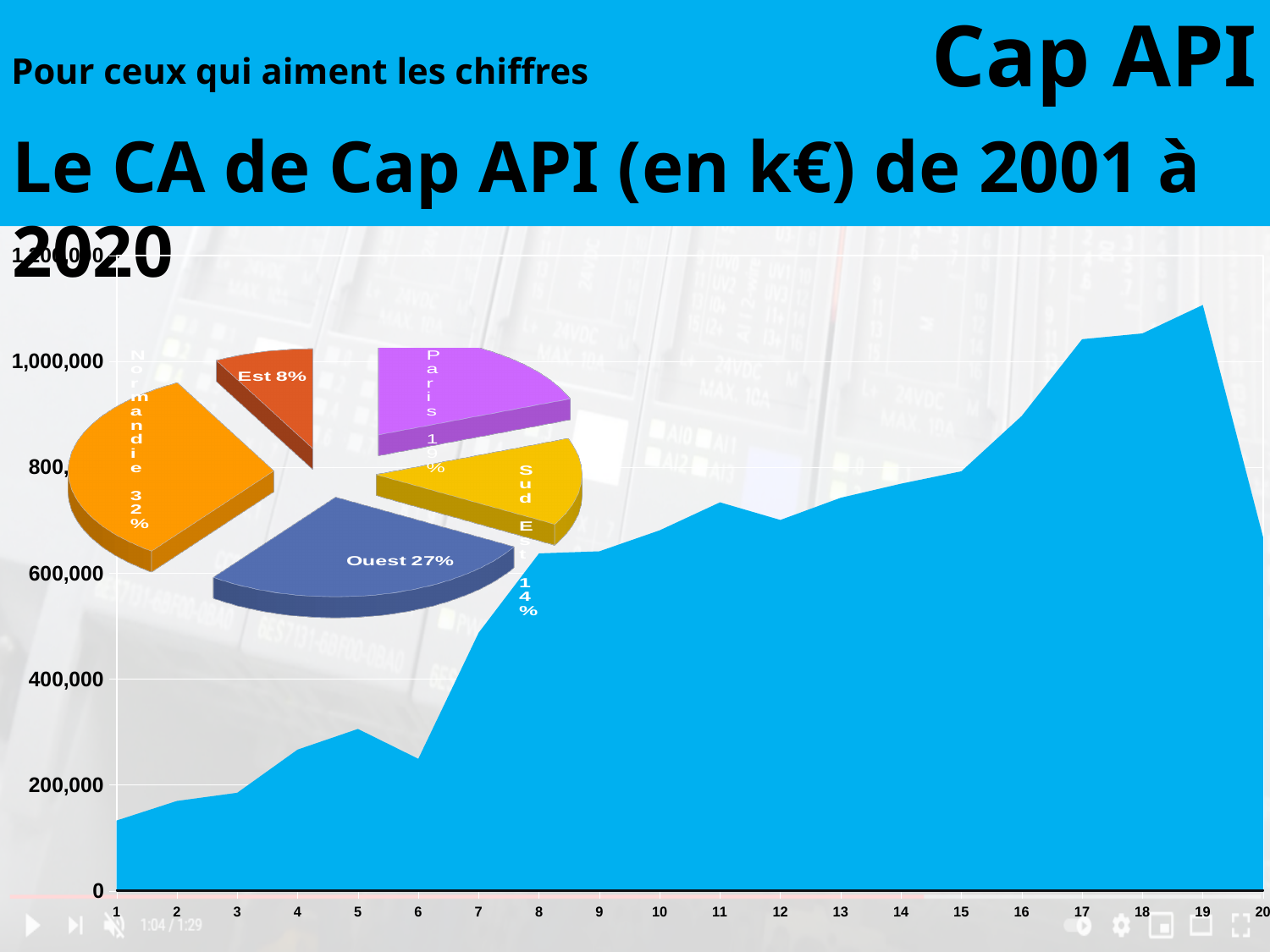
In the pie chart, what share does Normandie have? 32% In the area chart 'Le CA de Cap API', how many points are plotted along the x axis? 20 In the area chart 'Le CA de Cap API', do the values generally rise or fall from point 1 to point 19? rise In the pie chart, which region has the smallest slice? Est In the area chart 'Le CA de Cap API', at which x-axis point is the value lowest? 1 What kind of chart is the large blue chart titled 'Le CA de Cap API (en k€) de 2001 à 2020'? area chart In the area chart 'Le CA de Cap API', is the value at point 6 greater or less than 400,000? less In the area chart 'Le CA de Cap API', at which x-axis point is the value highest? 19 In the pie chart, what is the difference between the Normandie share and the Ouest share? 5% In the area chart 'Le CA de Cap API', is the value at point 17 greater or less than 1,000,000? greater In the area chart 'Le CA de Cap API', is the value at point 11 greater or less than 600,000? greater In the area chart 'Le CA de Cap API', which is larger, the value at point 19 or the value at point 20? point 19